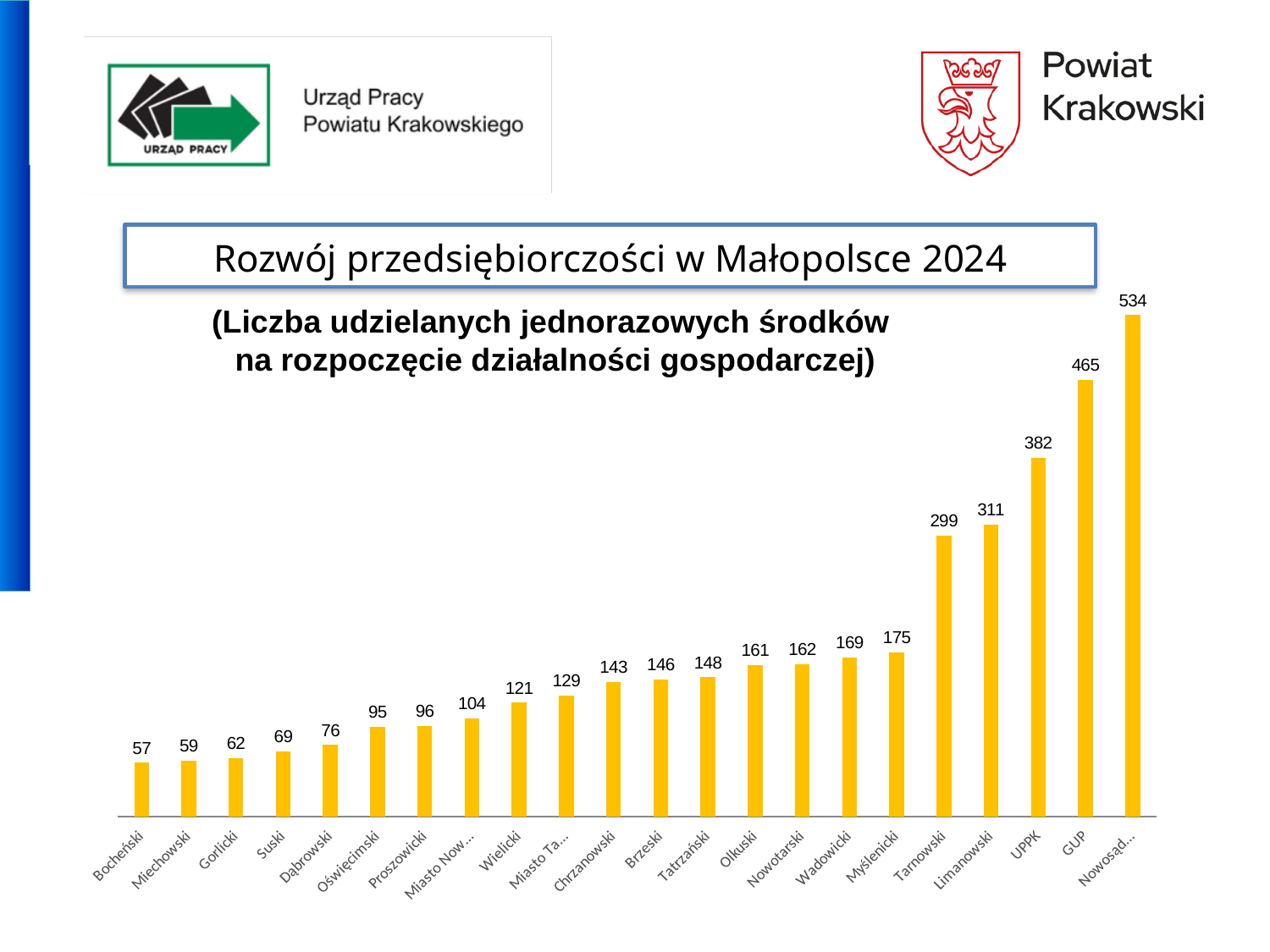
What is the value for UPPK? 382 Which is larger, the value for Myślenicki or the value for Wadowicki? Myślenicki What is the value for GUP? 465 What is the value for Tarnowski? 299 Which category has the lowest value? Bocheński What is the value for Wielicki? 121 What kind of chart is shown on the slide? bar chart What is the difference between the values for GUP and UPPK? 83 What is the highest value shown on the chart? 534 What is the difference between the values for Limanowski and Tarnowski? 12 How many categories are shown on the chart? 22 Do the values rise or fall from left to right along the x axis? rise